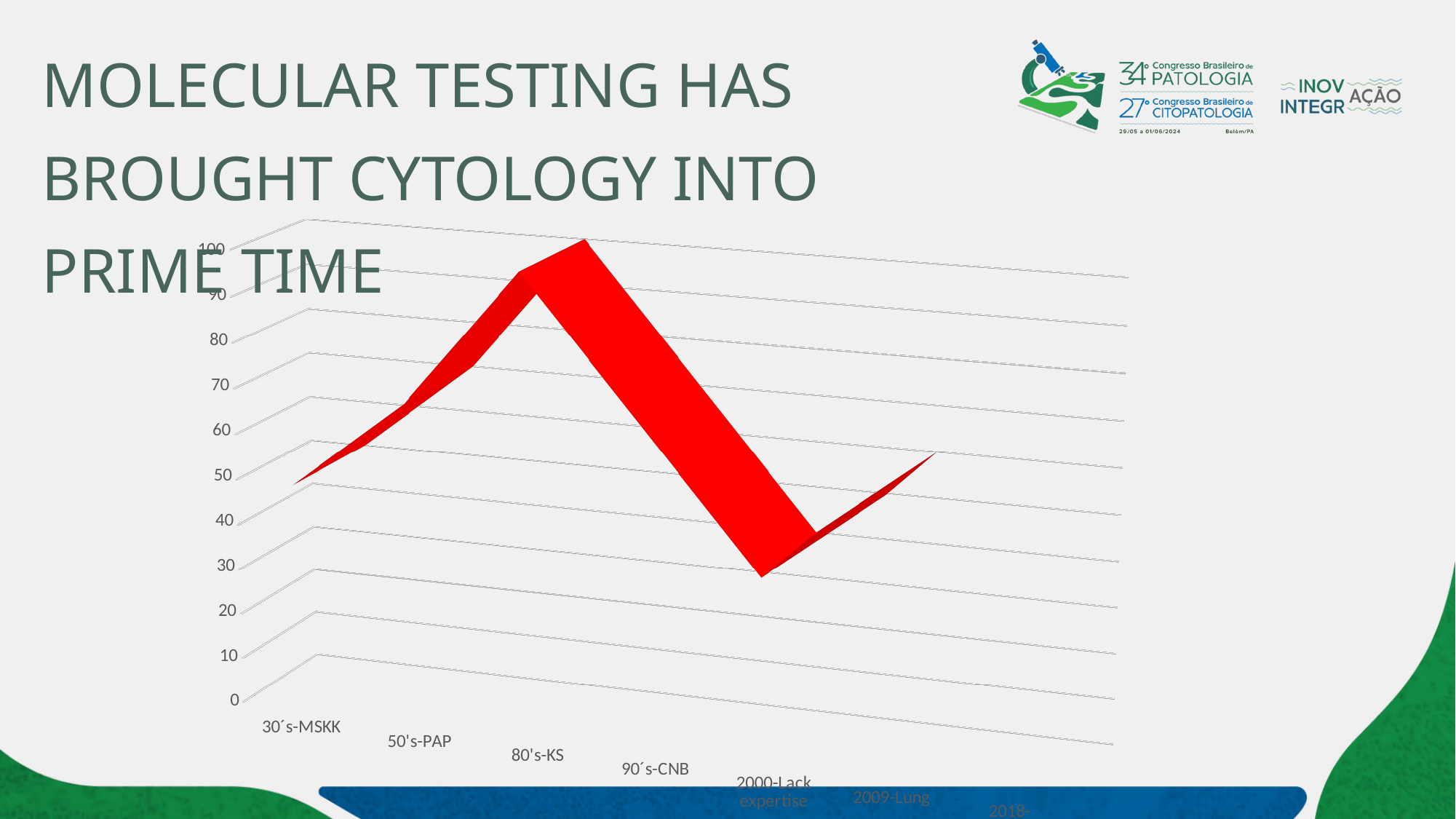
Is the value for 30´s-MSKK greater or less than 80? less Which is larger, the value for 80's-KS or the value for 2000-Lack expertise? 80's-KS Is the value for 80's-KS greater or less than 80? greater Which category has the lowest value on the chart? 2000-Lack expertise What kind of chart is shown on the slide? line chart What is the maximum value shown on the vertical axis of the chart? 100 What colour is the plotted line on the chart? red Is the value for 2000-Lack expertise greater or less than 50? less Which category has the highest value on the chart? 80's-KS Do the values rise or fall from 80's-KS to 2000-Lack expertise? fall Do the values rise or fall from 30´s-MSKK to 80's-KS? rise Which is larger, the value for 80's-KS or the value for 30´s-MSKK? 80's-KS